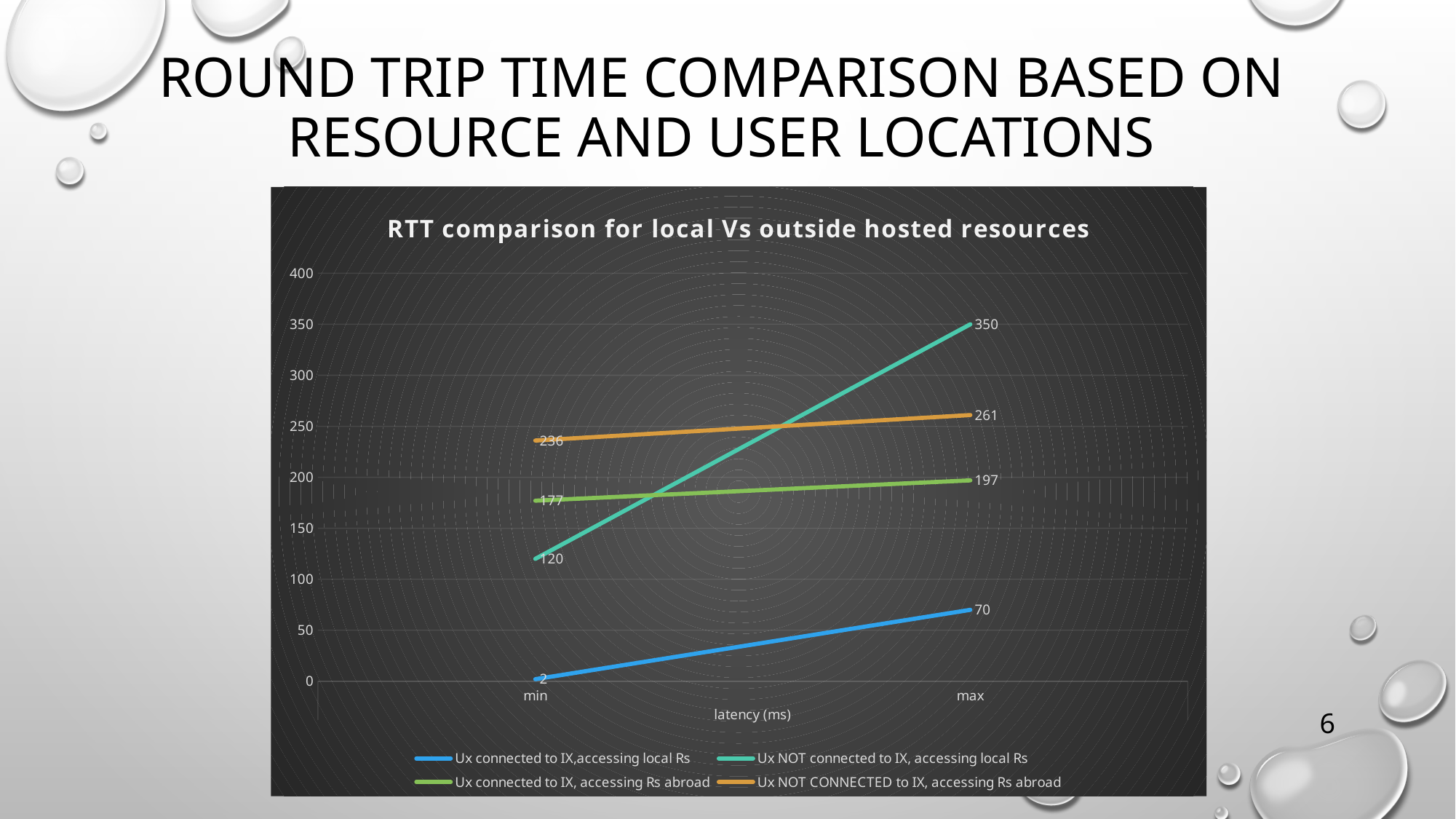
How many categories are on the x axis? 2 What is the min value for 'Ux connected to IX,accessing local Rs'? 2 What is the difference between the max and min values for 'Ux NOT connected to IX, accessing local Rs'? 230 Which series has the highest value at max? Ux NOT connected to IX, accessing local Rs Which series has the lowest value at min? Ux connected to IX,accessing local Rs What is the max value for 'Ux NOT CONNECTED to IX, accessing Rs abroad'? 261 At min, which is larger: 'Ux NOT CONNECTED to IX, accessing Rs abroad' or 'Ux connected to IX, accessing Rs abroad'? Ux NOT CONNECTED to IX, accessing Rs abroad What is the min value for 'Ux connected to IX, accessing Rs abroad'? 177 What is the title of the chart? RTT comparison for local Vs outside hosted resources What type of chart is shown on the slide? line chart What is the max value for 'Ux NOT connected to IX, accessing local Rs'? 350 How many series does the legend list? 4